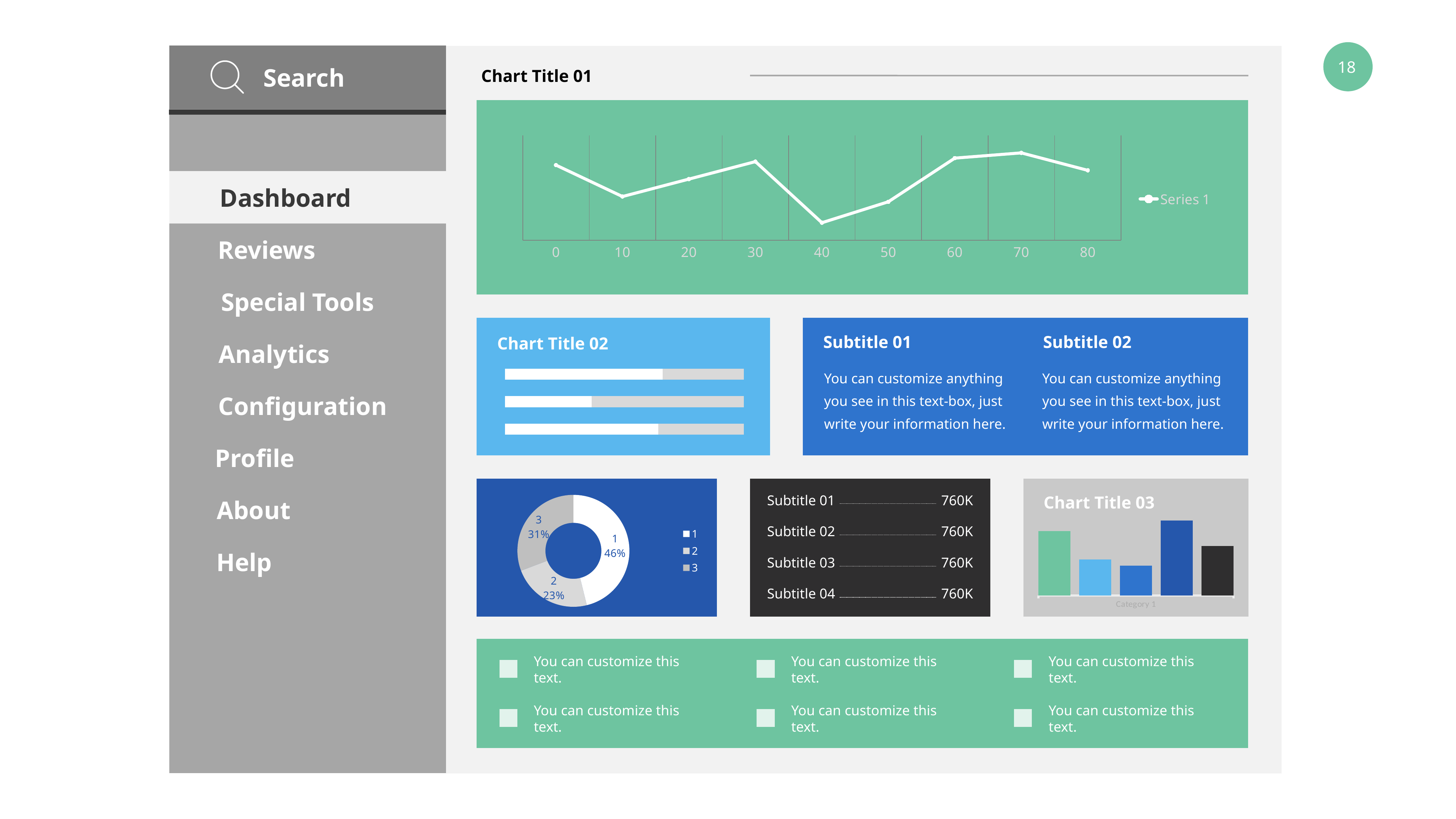
In Chart Title 01, at which x-axis value does the line reach its lowest point? 40 In Chart Title 01, what is the name of the series in the legend? Series 1 In Chart Title 01, how many data points are plotted on the line? 9 In Chart Title 03, how many bars are shown? 5 In Chart Title 01, at which x-axis value does the line reach its highest point? 70 In Chart Title 01, what kind of chart is shown? line chart In the doughnut chart at the bottom left, what is the difference between the shares of slice 3 and slice 2? 8% In the doughnut chart at the bottom left, what share does slice 2 have? 23% In Chart Title 01, is the value at x = 30 larger or smaller than the value at x = 40? larger In the doughnut chart at the bottom left, what share does slice 1 have? 46% In Chart Title 01, how many series does the legend list? 1 In the doughnut chart at the bottom left, which slice is the largest? 1